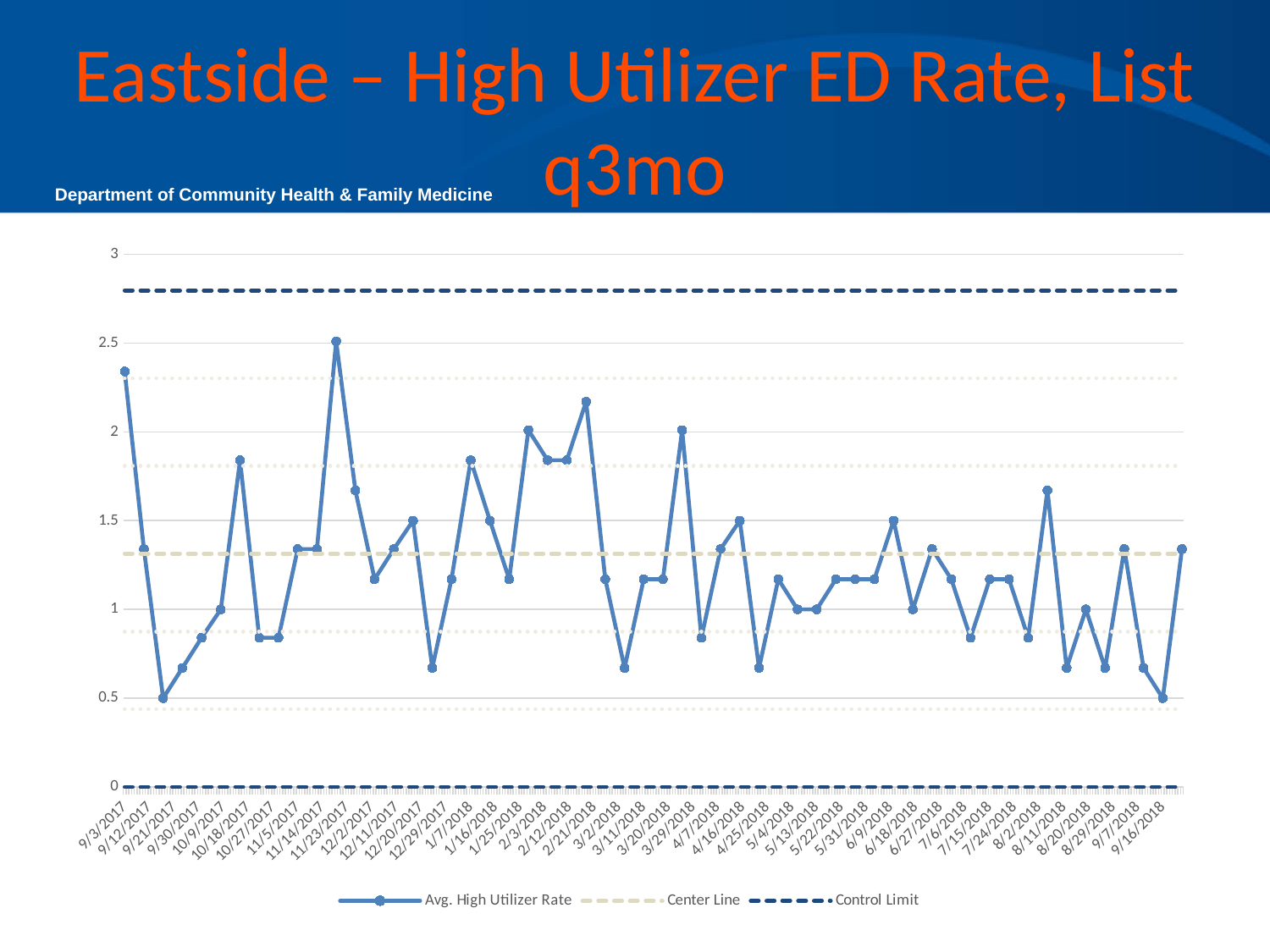
Is the Control Limit line greater or less than 2.5? greater How many series does the legend list? 3 What are the three entries listed in the chart legend? Avg. High Utilizer Rate, Center Line, Control Limit What kind of chart is shown on the slide? line chart Is the Avg. High Utilizer Rate for 9/21/2017 greater or less than 1? less